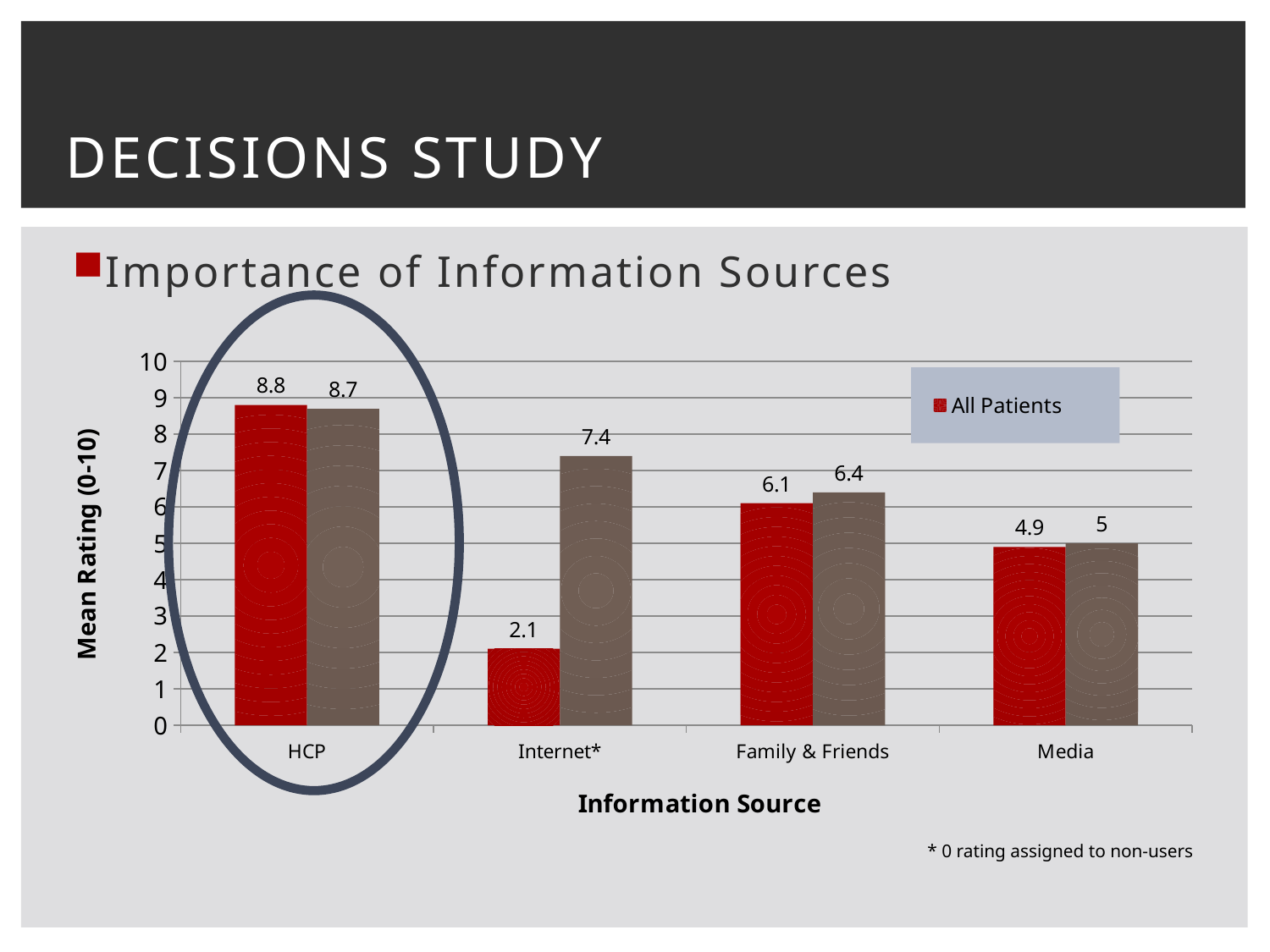
What is the All Patients mean rating for Internet*? 2.1 For All Patients, which has a higher mean rating: Family & Friends or Media? Family & Friends What is the All Patients mean rating for Family & Friends? 6.1 Which information source has the lowest All Patients mean rating? Internet* How many information sources are shown on the x axis? 4 What is the difference between the All Patients mean ratings for Family & Friends and Media? 1.2 What kind of chart is shown on the slide? Bar chart What is the All Patients mean rating for HCP? 8.8 What is the All Patients mean rating for Media? 4.9 What is the title of the y axis? Mean Rating (0-10) What is the difference between the All Patients mean ratings for HCP and Internet*? 6.7 Which information source has the highest All Patients mean rating? HCP